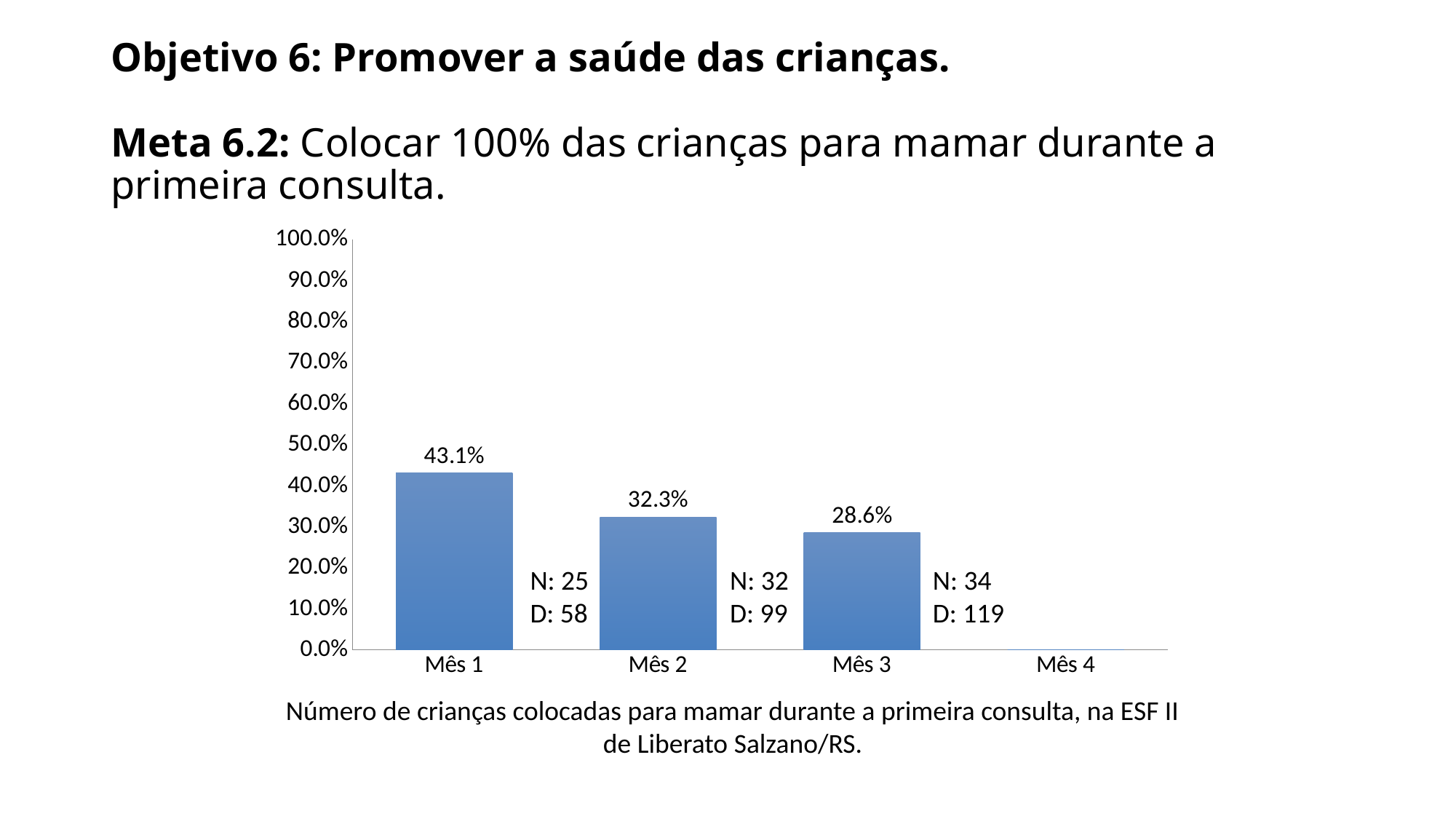
How many months are shown on the x axis of the chart? 4 Do the values rise or fall from Mês 1 to Mês 3? Fall Among Mês 1, Mês 2 and Mês 3, which has the lowest value? Mês 3 Which is larger, the value for Mês 2 or the value for Mês 3? Mês 2 What is the difference between the values for Mês 2 and Mês 3? 3.7% What is the value shown for Mês 3? 28.6% What is the value shown for Mês 1? 43.1% Which month has the highest value in the chart? Mês 1 What kind of chart is shown on the slide? Bar chart Is the value for Mês 1 greater or less than 40.0%? greater What is the difference between the values for Mês 1 and Mês 2? 10.8% What is the value shown for Mês 2? 32.3%